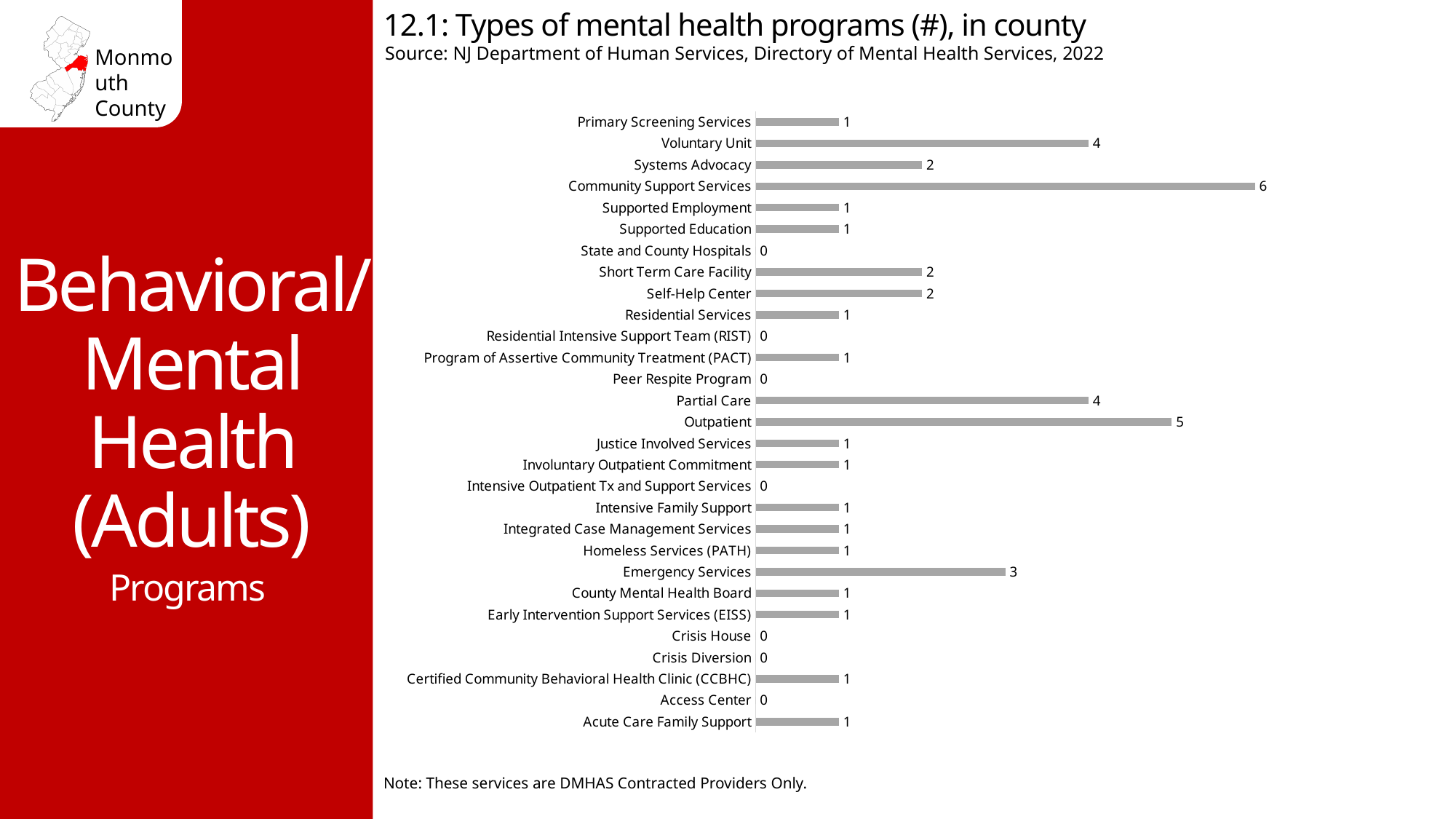
What kind of chart is shown on the slide? Bar chart How many program types are listed in the chart? 29 What is the value for Peer Respite Program? 0 How many program types have a value of 0? 7 What is the value for Emergency Services? 3 Which type of mental health program has the highest count? Community Support Services What is the difference between the values for Voluntary Unit and Systems Advocacy? 2 What is the value for Outpatient? 5 What is the difference between the values for Community Support Services and Outpatient? 1 Which is larger, the value for Partial Care or the value for Emergency Services? Partial Care How many Community Support Services programs are shown in the chart? 6 Which is larger, the value for Self-Help Center or the value for Residential Services? Self-Help Center